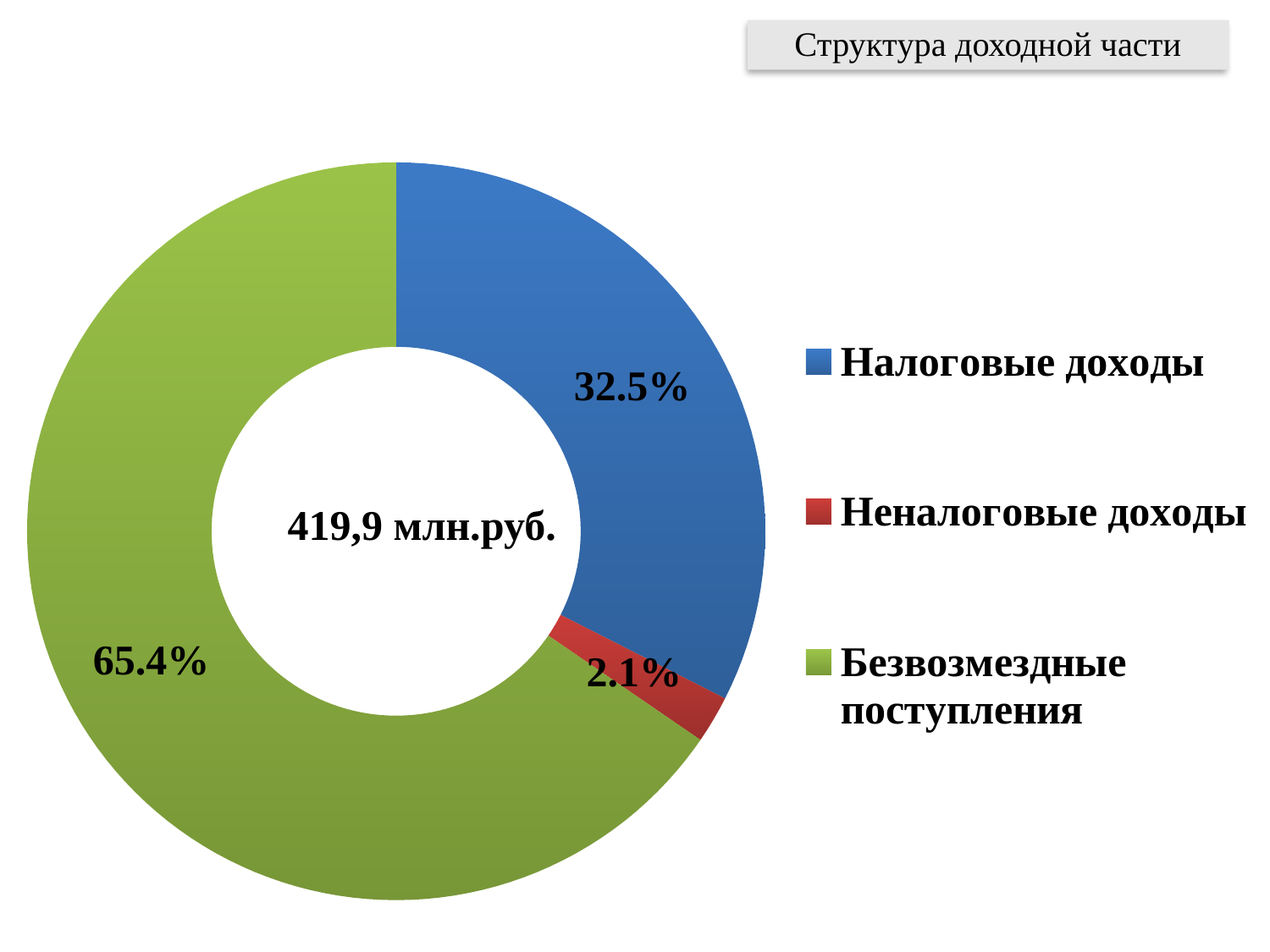
What share of the chart does Безвозмездные поступления have? 65.4% What is the difference in percentage points between Налоговые доходы and Неналоговые доходы? 30.4 What share of the chart does Налоговые доходы have? 32.5% What total value is printed in the centre of the chart? 419,9 млн.руб. Which is larger, Налоговые доходы or Неналоговые доходы? Налоговые доходы What share of the chart does Неналоговые доходы have? 2.1% Which category has the largest share? Безвозмездные поступления What is the difference in percentage points between Безвозмездные поступления and Налоговые доходы? 32.9 What kind of chart is shown on the slide? Pie chart (doughnut) What colour is the Безвозмездные поступления slice? Green Which category has the smallest share? Неналоговые доходы How many categories does the chart show? 3